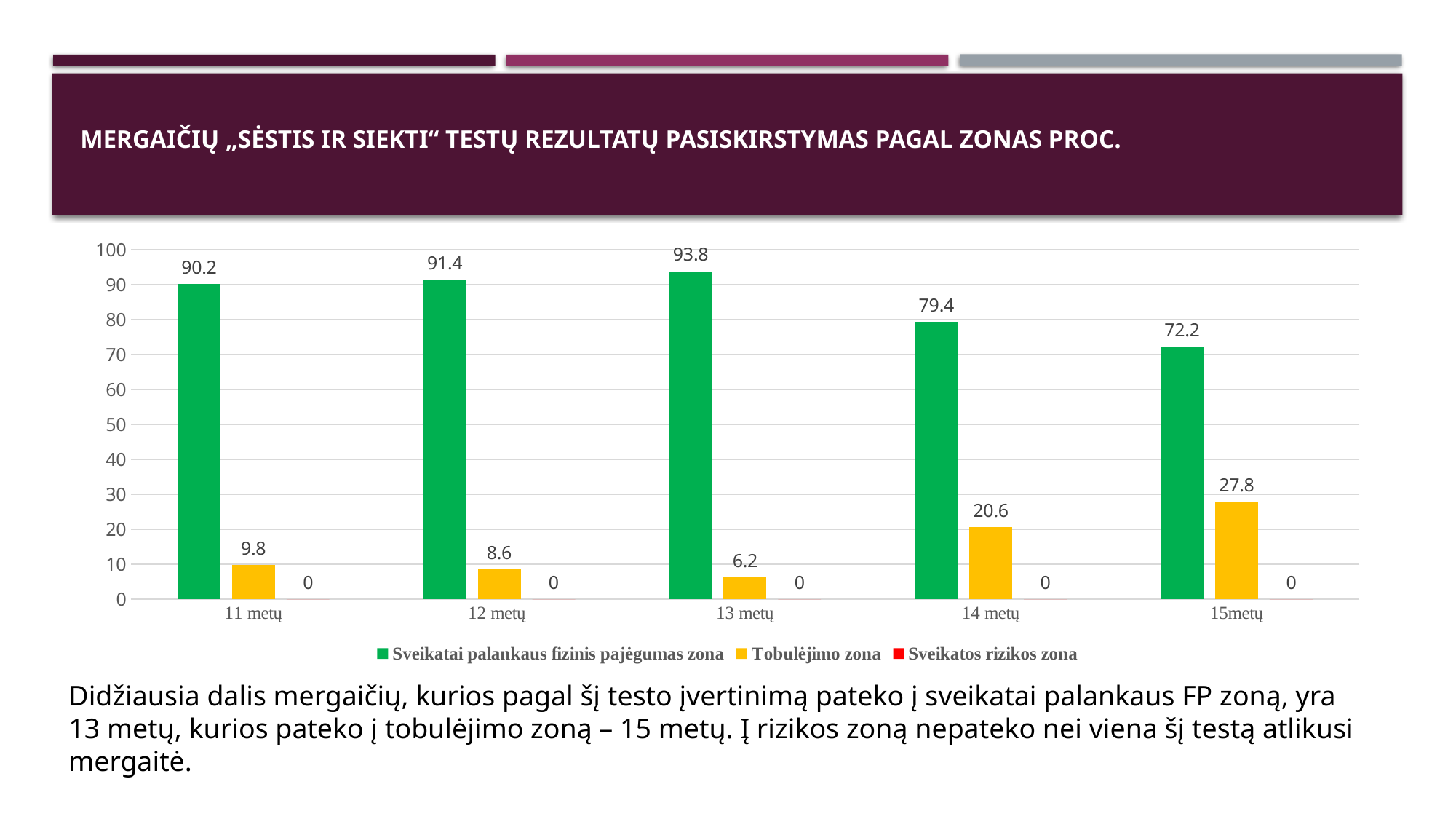
What is the value of "Tobulėjimo zona" for 15metų? 27.8 Is the "Sveikatai palankaus fizinis pajėgumas zona" value for 14 metų greater or less than 80? less What colour represents "Tobulėjimo zona" in the chart? yellow What kind of chart is shown on the slide? bar chart What is the value of "Sveikatai palankaus fizinis pajėgumas zona" for 13 metų? 93.8 Which age group has the lowest value for "Tobulėjimo zona"? 13 metų What is the value of "Sveikatos rizikos zona" for 11 metų? 0 How many age groups are shown on the x axis? 5 What is the difference between the "Sveikatai palankaus fizinis pajėgumas zona" values for 13 metų and 15metų? 21.6 Which age group has the highest value for "Sveikatai palankaus fizinis pajėgumas zona"? 13 metų How many series does the legend list? 3 Which is larger: the "Tobulėjimo zona" value for 14 metų or for 15metų? 15metų